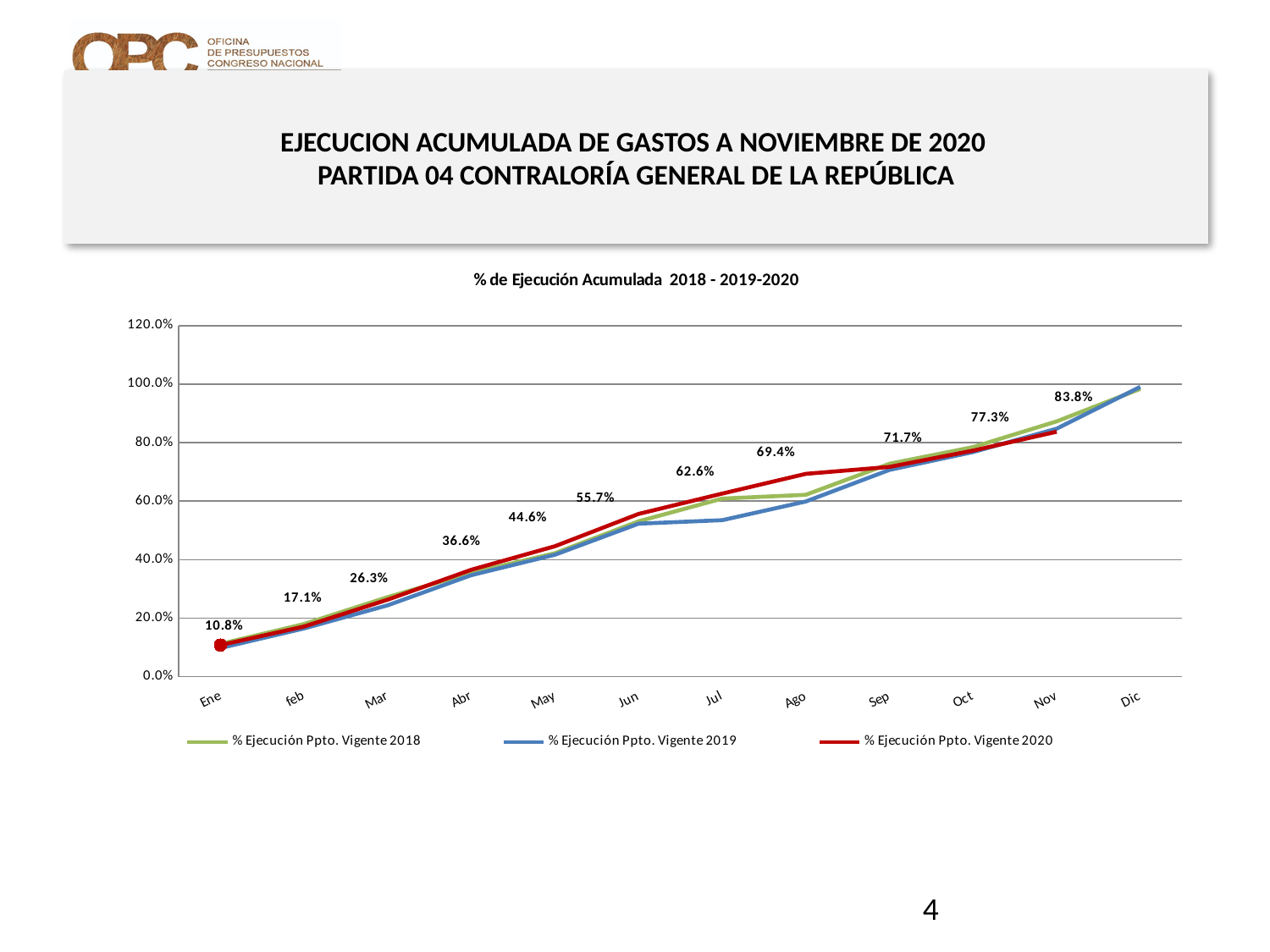
What is the value for % Ejecución Ppto. Vigente 2020 in Ene? 10.8% What is the difference between the % Ejecución Ppto. Vigente 2020 values for Nov and Oct? 6.5% Is the value for % Ejecución Ppto. Vigente 2019 in Jul greater or less than 60.0%? less What is the value for % Ejecución Ppto. Vigente 2020 in Nov? 83.8% What type of chart is shown on the slide? line chart How many months are shown on the x axis? 12 How many series does the legend list? 3 Does the % Ejecución Ppto. Vigente 2020 line rise or fall from Ene to Nov? rise In Ago, which is larger: % Ejecución Ppto. Vigente 2020 or % Ejecución Ppto. Vigente 2019? % Ejecución Ppto. Vigente 2020 What is the difference between the % Ejecución Ppto. Vigente 2020 values for Ago and Jul? 6.8% What is the title of the chart? % de Ejecución Acumulada 2018 - 2019-2020 What is the value for % Ejecución Ppto. Vigente 2020 in Jun? 55.7%